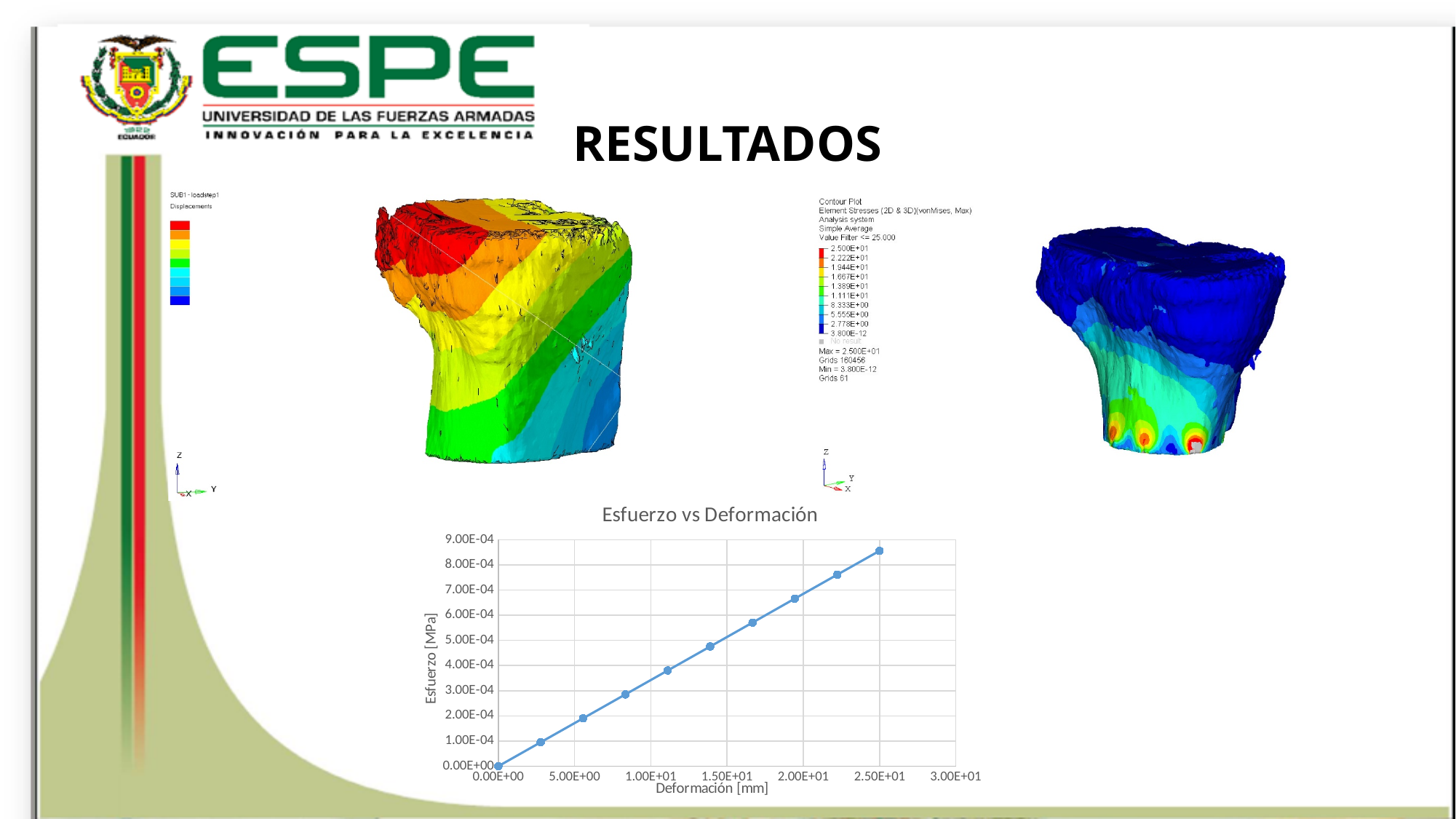
What type of chart is the 'Esfuerzo vs Deformación' chart? line chart In the 'Esfuerzo vs Deformación' chart, is the esfuerzo value at a deformación of 1.50E+01 mm greater or less than 6.00E-04? less In the 'Esfuerzo vs Deformación' chart, what is the esfuerzo value at a deformación of 0.00E+00 mm? 0.00E+00 In the 'Esfuerzo vs Deformación' chart, what is the highest value shown on the x axis? 3.00E+01 In the 'Esfuerzo vs Deformación' chart, at which deformación value is the esfuerzo highest? 2.50E+01 In the 'Esfuerzo vs Deformación' chart, is the esfuerzo value at a deformación of 2.50E+01 mm greater or less than 8.00E-04? greater In the 'Esfuerzo vs Deformación' chart, is the esfuerzo value at a deformación of 2.00E+01 mm greater or less than 6.00E-04? greater In the 'Esfuerzo vs Deformación' chart, what is the label of the y axis? Esfuerzo [MPa] In the 'Esfuerzo vs Deformación' chart, do the values rise or fall as deformation increases? rise In the 'Esfuerzo vs Deformación' chart, how many data points are plotted? 10 What is the title of the chart at the bottom of the slide? Esfuerzo vs Deformación